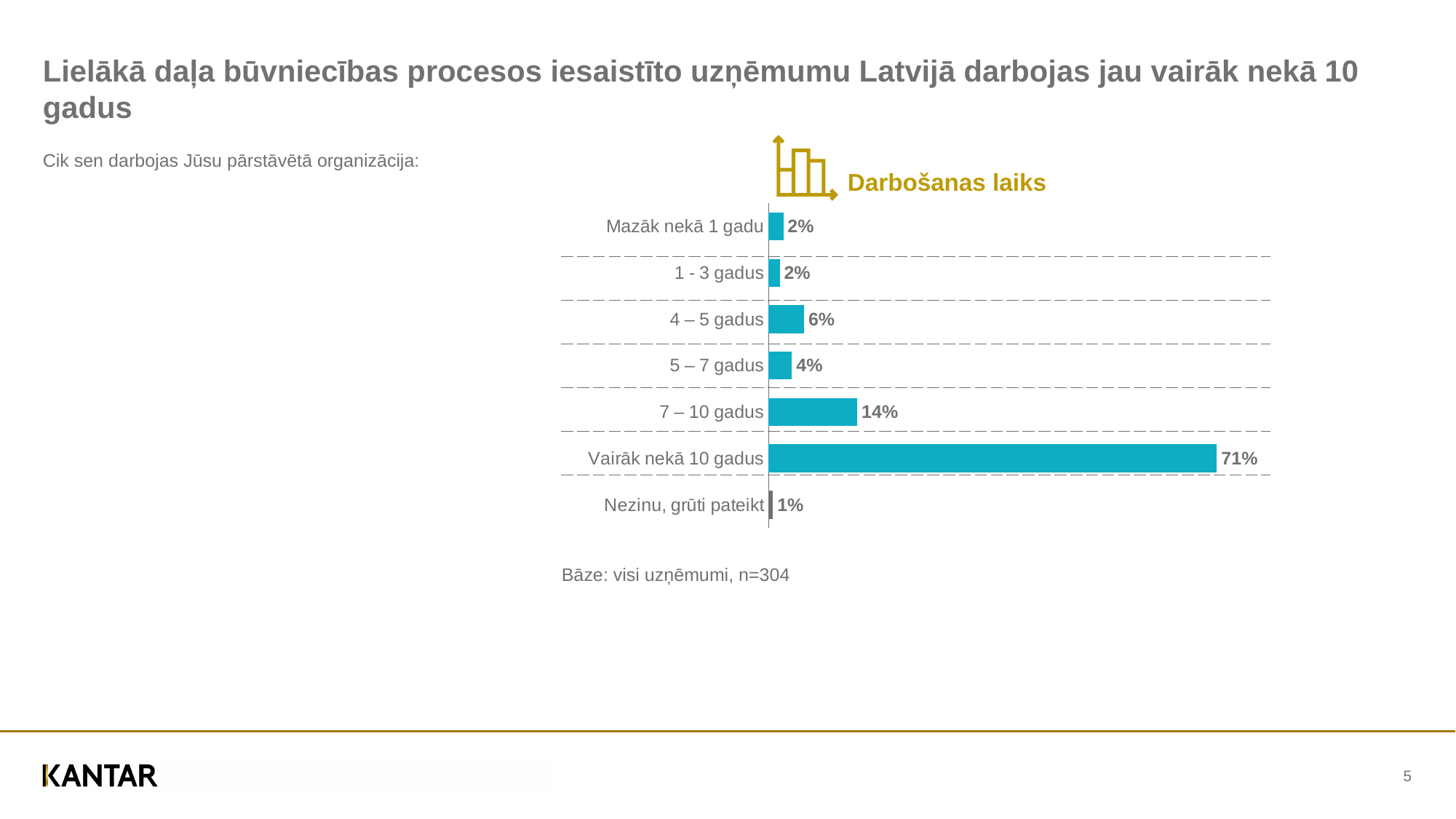
What is the value for "7 – 10 gadus"? 14% What is the value for "4 – 5 gadus"? 6% Which category has the highest value? Vairāk nekā 10 gadus What is the difference between the values for "Vairāk nekā 10 gadus" and "7 – 10 gadus"? 57% Which category has the lowest value? Nezinu, grūti pateikt How many categories are shown in the chart? 7 What is the value for "Vairāk nekā 10 gadus"? 71% What is the title of the chart? Darbošanas laiks What kind of chart is shown on the slide? Bar chart What is the base (n) stated below the chart? n=304 What is the value for "Nezinu, grūti pateikt"? 1% Which is larger, the value for "4 – 5 gadus" or "5 – 7 gadus"? 4 – 5 gadus